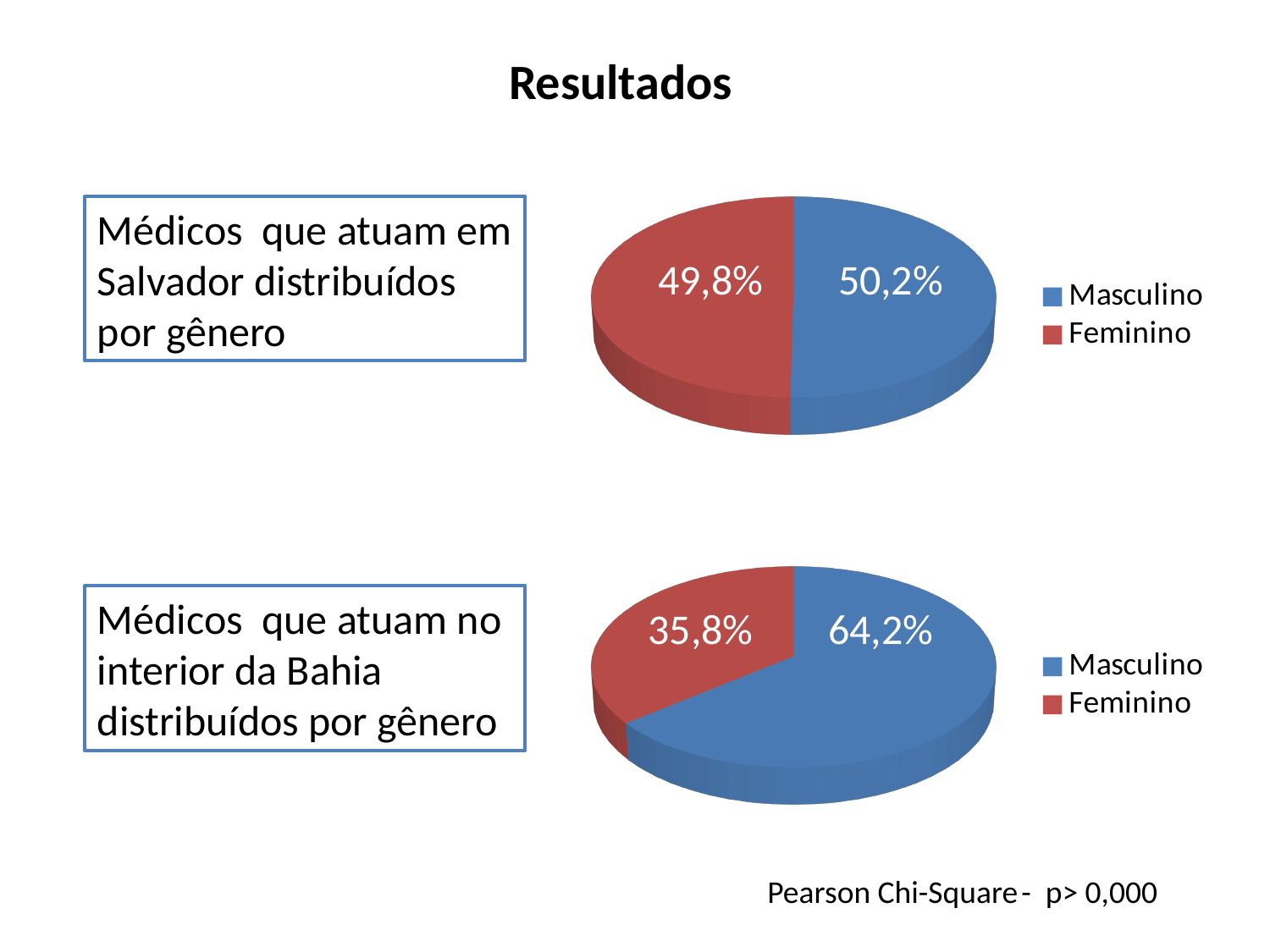
In the top pie chart (Médicos que atuam em Salvador), what percentage is Masculino? 50,2% In the top pie chart (Médicos que atuam em Salvador), what percentage is Feminino? 49,8% In the bottom pie chart (interior da Bahia), which gender has the largest share? Masculino What type of chart is used for the Salvador gender distribution? Pie chart In the bottom pie chart (interior da Bahia), which gender has the smallest share? Feminino How many slices does the bottom pie chart (interior da Bahia) have? 2 In the bottom pie chart (interior da Bahia), what is the difference between the Masculino and Feminino shares? 28,4% In the bottom pie chart (interior da Bahia), what colour represents Feminino? Red How many entries does the legend of the top pie chart list? 2 In the top pie chart (Salvador), which is larger according to the data labels, Masculino or Feminino? Masculino In the bottom pie chart (Médicos que atuam no interior da Bahia), what percentage is Masculino? 64,2% In the bottom pie chart (Médicos que atuam no interior da Bahia), what percentage is Feminino? 35,8%